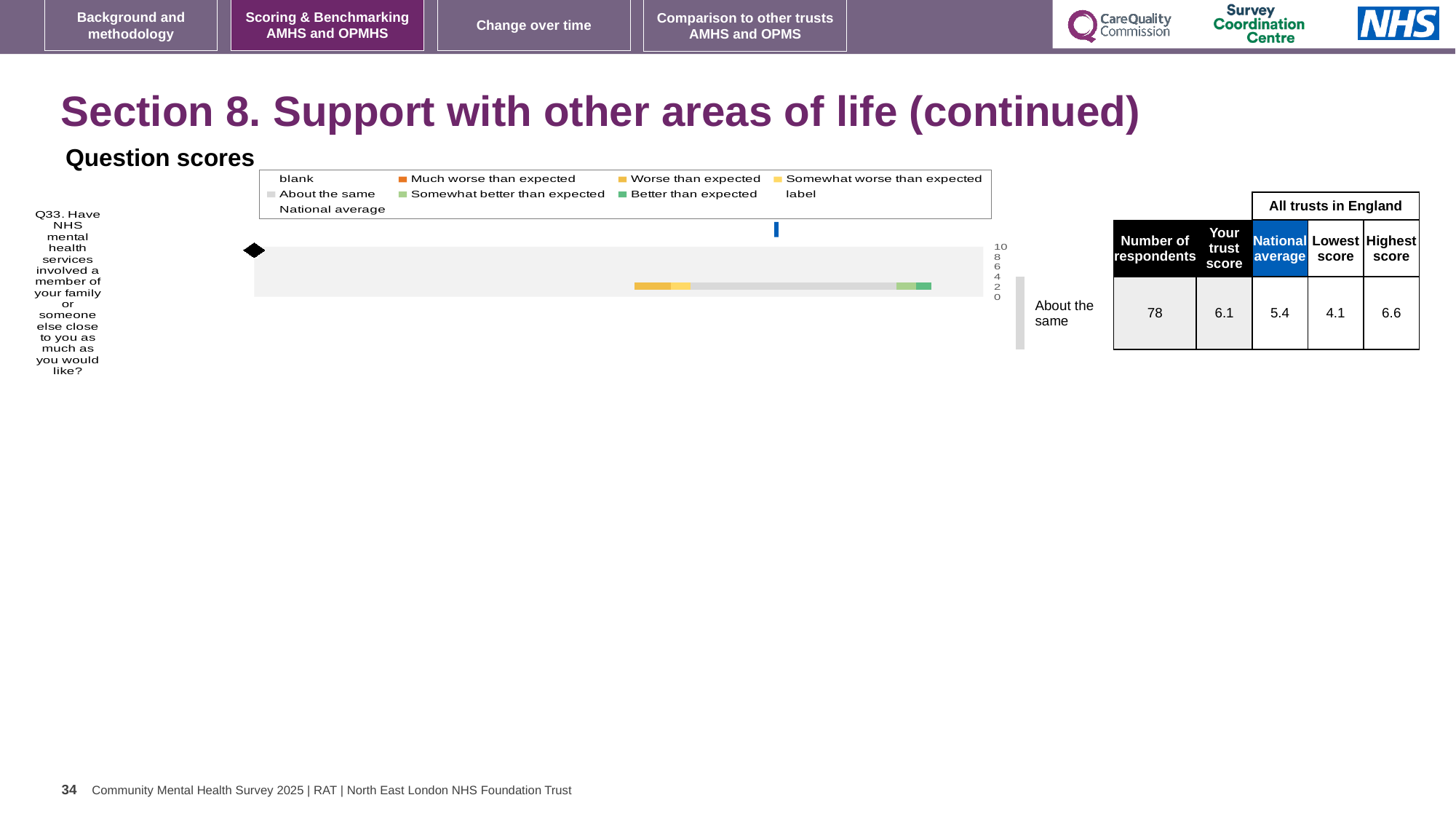
What kind of chart is shown under "Question scores"? bar chart In the legend of the Question scores chart, which entry is shown in grey? About the same What benchmark category is shown beside the bar for Q33 in the Question scores chart? About the same How many entries does the legend of the Question scores chart list? 9 Which question is plotted in the Question scores chart? Q33. Have NHS mental health services involved a member of your family or someone else close to you as much as you would like? How many questions are plotted in the Question scores chart? 1 What is the highest value shown on the axis of the Question scores chart? 10